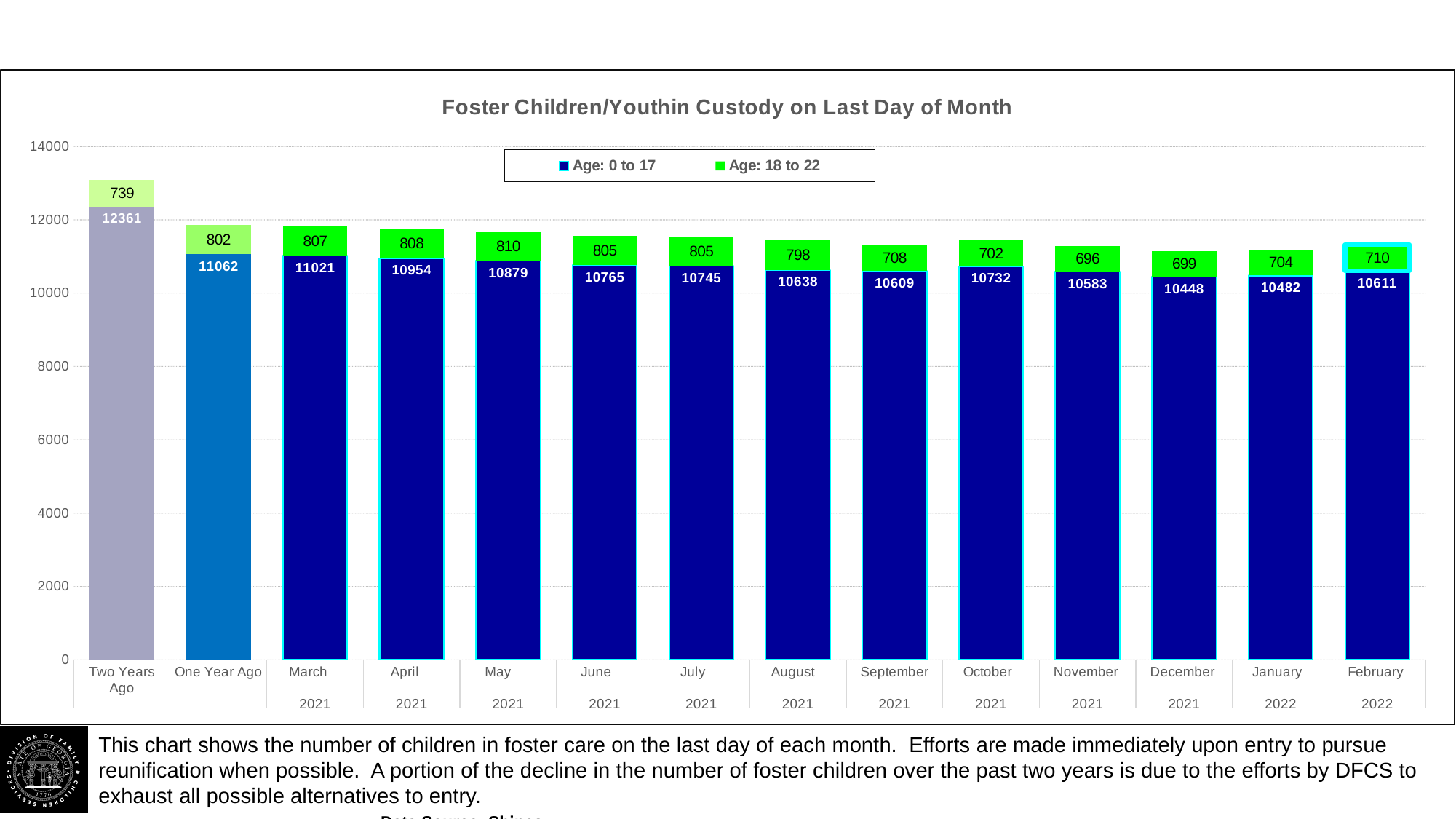
What is the difference between the Age: 0 to 17 values for Two Years Ago and One Year Ago? 1299 Which category has the lowest value for Age: 0 to 17? December 2021 What is the value for Age: 0 to 17 in February 2022? 10611 What kind of chart is this? Stacked bar chart How many categories are shown on the x axis? 14 What is the value for Age: 0 to 17 for Two Years Ago? 12361 How many series does the legend list? 2 What is the value for Age: 18 to 22 in May 2021? 810 Which is larger, the Age: 0 to 17 value for October 2021 or for November 2021? October 2021 Which category has the highest value for Age: 0 to 17? Two Years Ago Which category has the lowest value for Age: 18 to 22? November 2021 What is the total of the stacked bar for December 2021? 11147